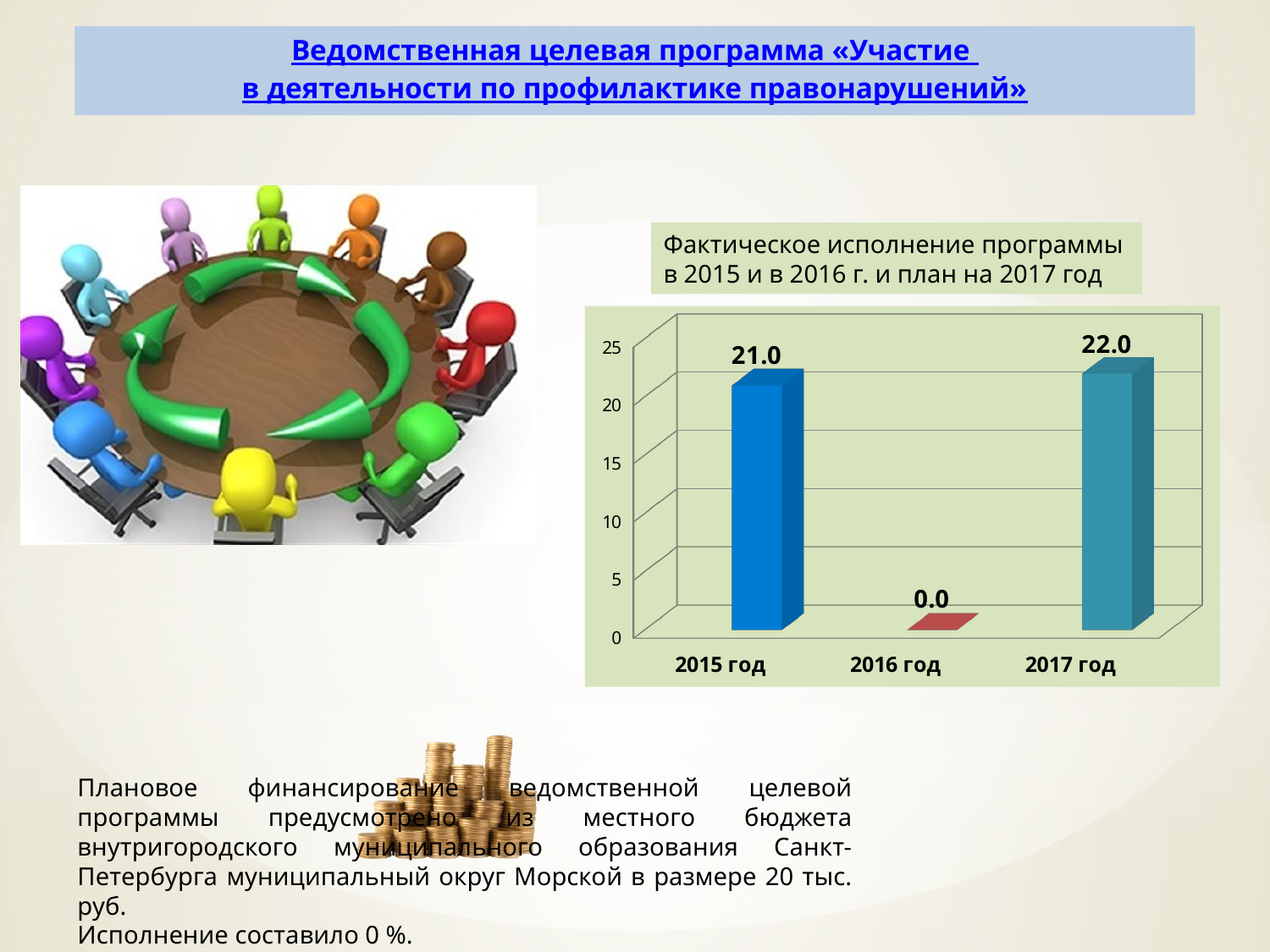
What is the value for 2016 год? 0.0 What kind of chart is shown on the slide? bar chart Which year has the lowest value? 2016 год What is the value for 2015 год? 21.0 What is the highest value shown on the vertical axis? 25 What is the value for 2017 год? 22.0 What is the title text above the chart? Фактическое исполнение программы в 2015 и в 2016 г. и план на 2017 год How many categories are shown on the x axis? 3 Which is larger, the value for 2015 год or the value for 2017 год? 2017 год Is the value for 2015 год greater or less than 20? greater Which year has the highest value? 2017 год What is the difference between the values for 2017 год and 2015 год? 1.0